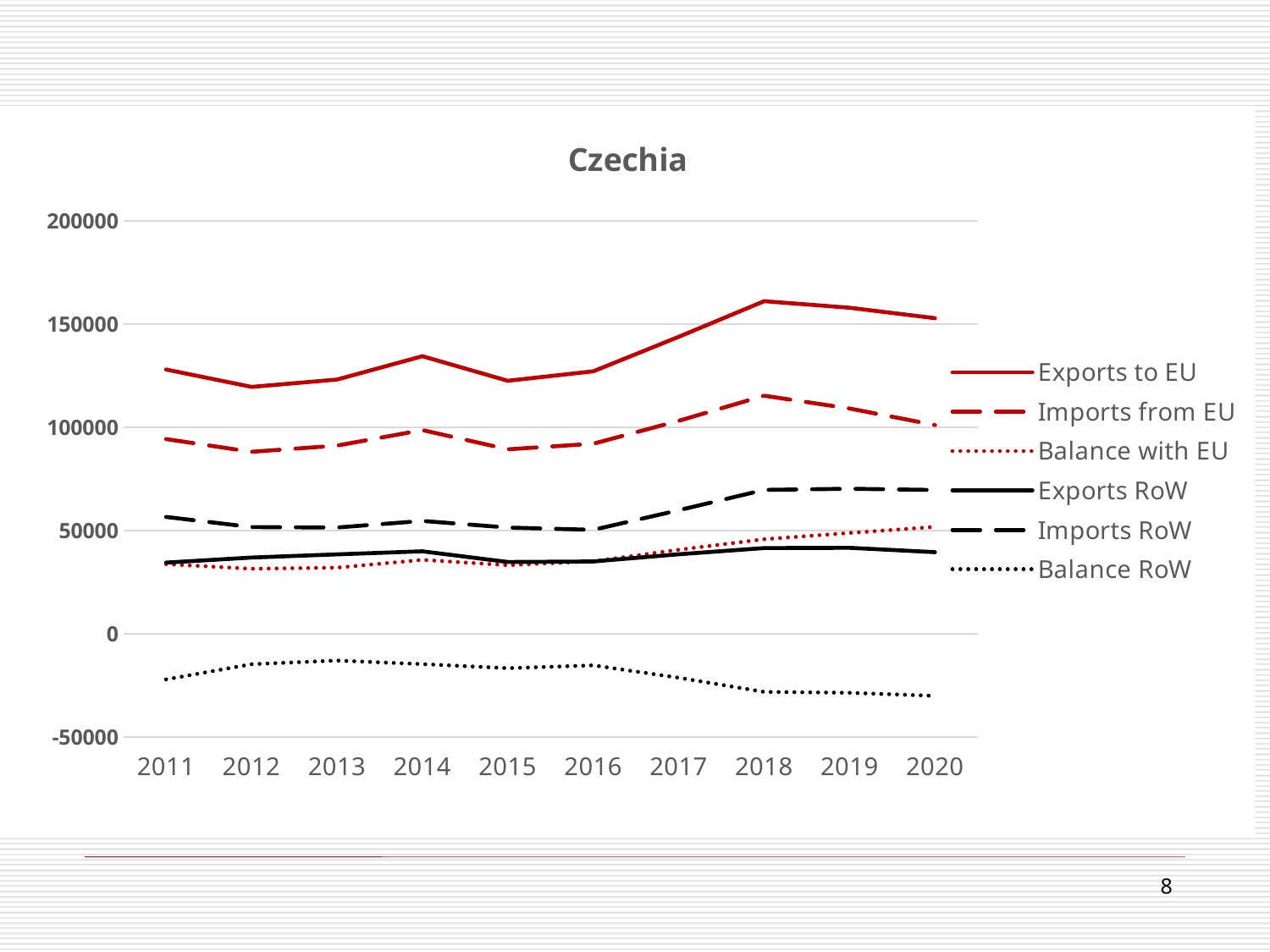
How many years are plotted along the x axis? 10 Which series has the lowest values across all years? Balance RoW How many series does the legend list? 6 In which year is the Exports to EU series at its lowest? 2012 Is the value for Balance RoW in 2020 greater or less than 0? less Is the value for Imports RoW in 2018 greater or less than 50000? greater What is the title of the chart? Czechia In 2020, which is larger: Exports to EU or Imports from EU? Exports to EU In which year is the Exports to EU series at its highest? 2018 Does the Balance RoW series rise or fall from 2016 to 2020? fall What kind of chart is shown on the slide? line chart Is the value for Exports to EU in 2018 greater or less than 150000? greater